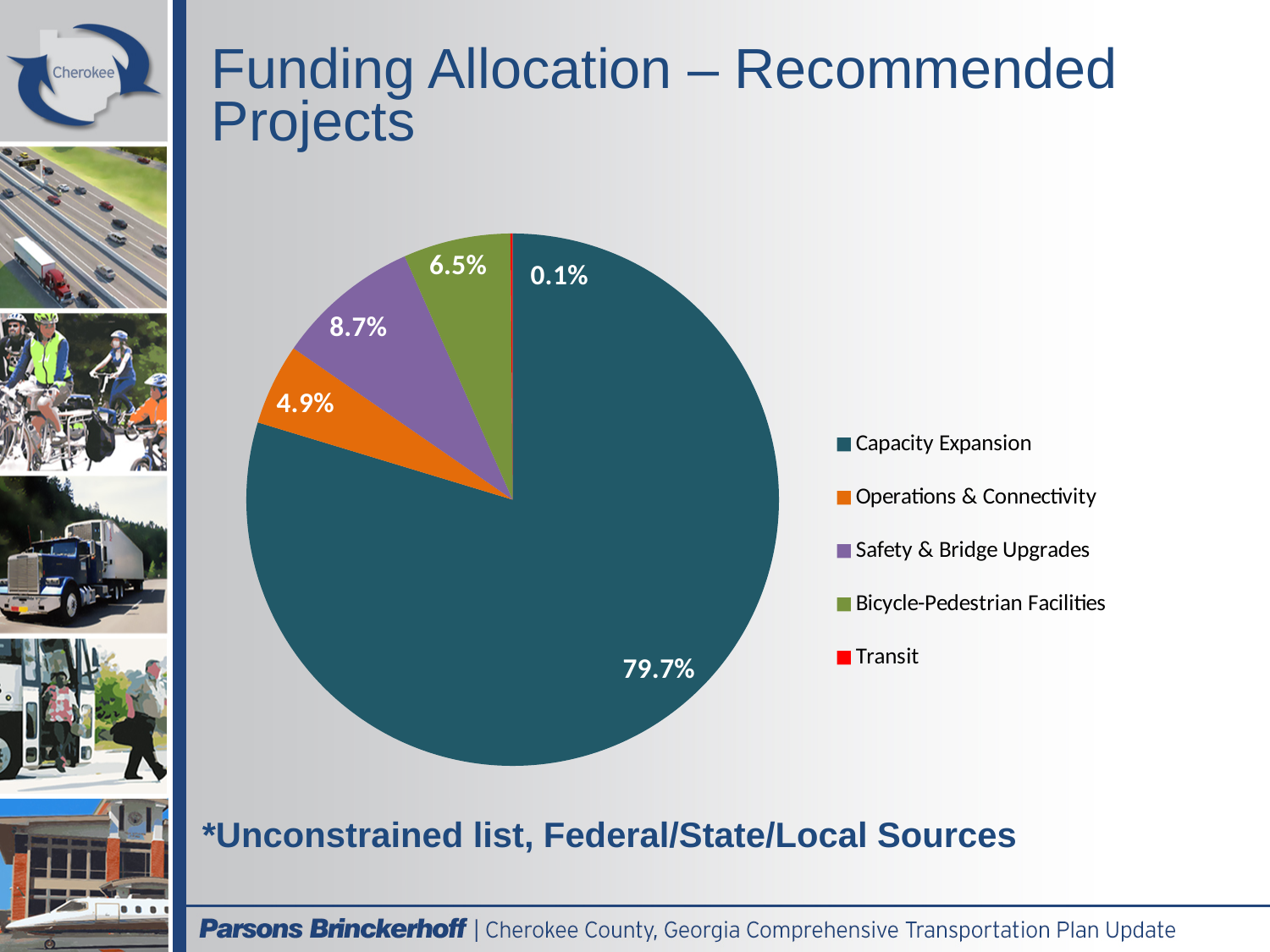
What kind of chart is shown on the slide? pie chart Which category receives the largest share of funding? Capacity Expansion Which category receives the smallest share of funding? Transit What is the difference in percentage points between Safety & Bridge Upgrades and Operations & Connectivity? 3.8 What share of funding is allocated to Bicycle-Pedestrian Facilities? 6.5% Which receives a larger share, Safety & Bridge Upgrades or Bicycle-Pedestrian Facilities? Safety & Bridge Upgrades How many categories does the pie chart show? 5 What share of funding is allocated to Safety & Bridge Upgrades? 8.7% What colour represents Operations & Connectivity in the pie chart? orange What share of funding is allocated to Transit? 0.1% What share of funding is allocated to Operations & Connectivity? 4.9% What share of funding is allocated to Capacity Expansion? 79.7%